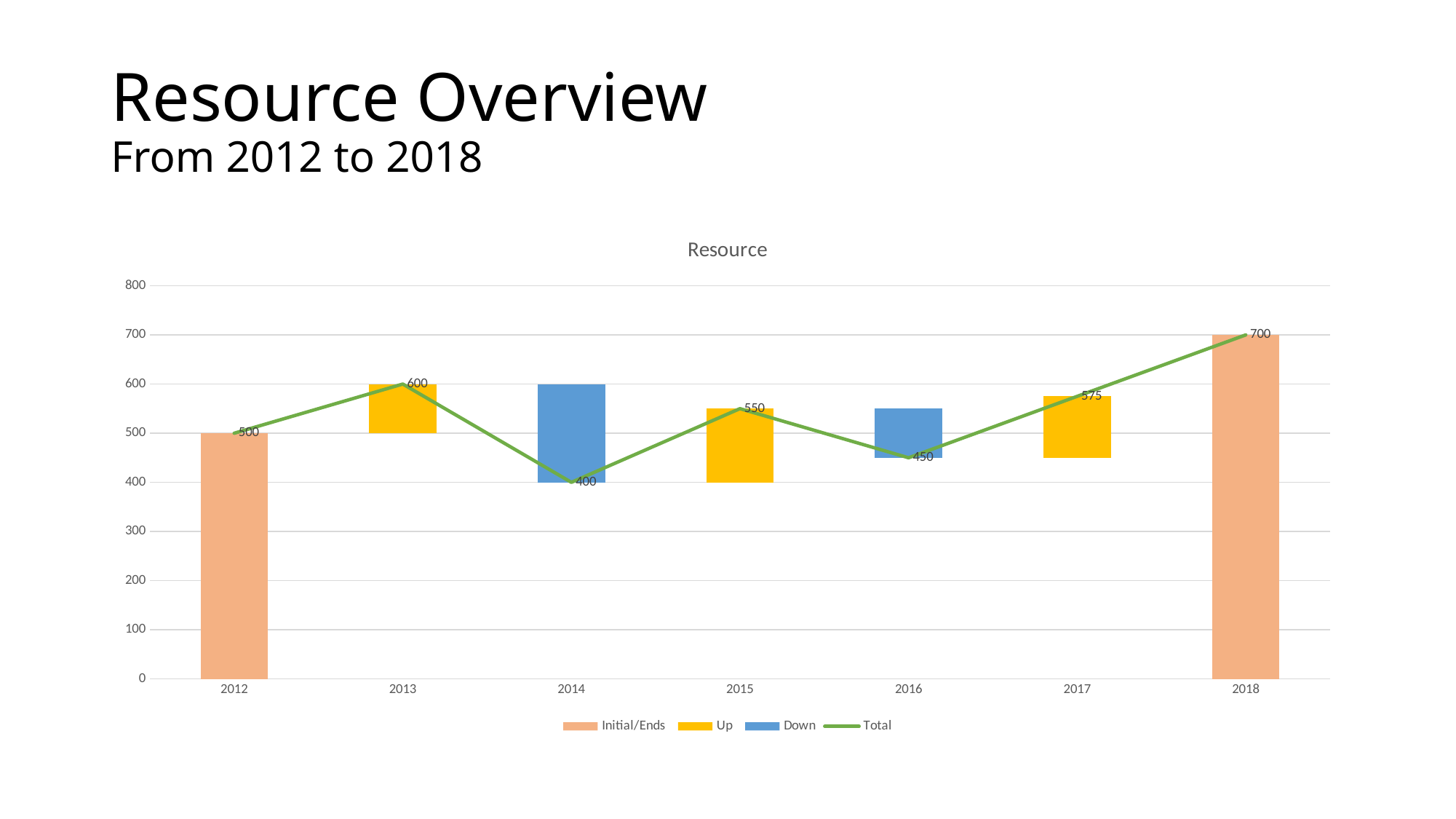
How many years are shown on the x axis? 7 What is the title of the chart? Resource What is the Total value for 2014? 400 Which year has the highest Total value? 2018 What is the Total value for 2018? 700 How many series does the legend list? 4 Which is larger, the Total value for 2013 or for 2015? 2013 What is the Total value for 2017? 575 What is the difference between the Total values for 2018 and 2012? 200 What is the Total value for 2012? 500 Does the Total line rise or fall from 2015 to 2016? fall Which year has the lowest Total value? 2014